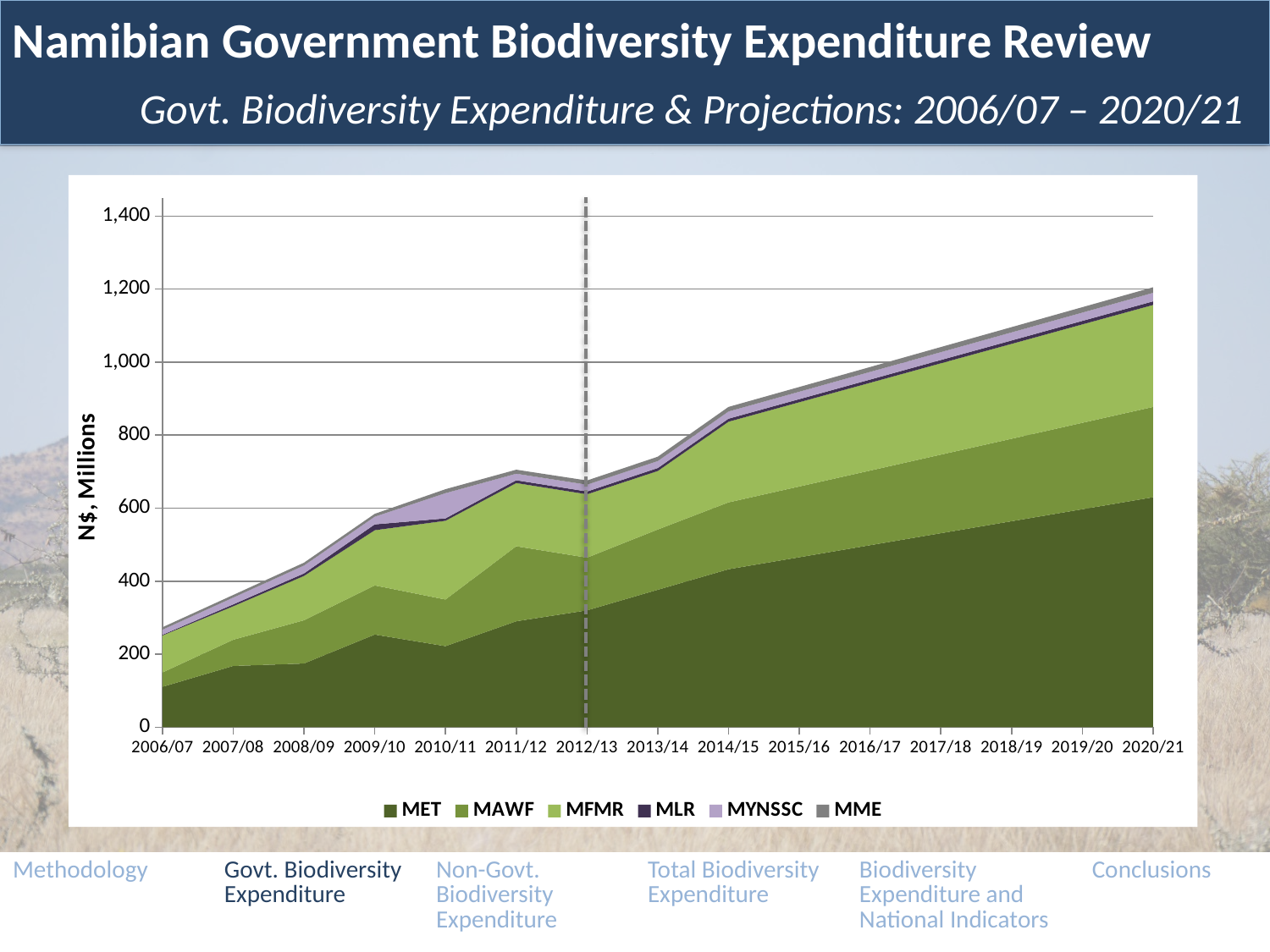
Is the total stacked expenditure for 2006/07 greater or less than 400? less Is the MET value for 2020/21 greater or less than 400? greater In which year is the total stacked expenditure lowest? 2006/07 Does total government biodiversity expenditure generally rise or fall from 2006/07 to 2020/21? Rise Is the total stacked expenditure for 2020/21 greater or less than 1,000? greater What kind of chart is shown on the slide? Stacked area chart In which year is the total stacked expenditure highest? 2020/21 Which year has the larger total stacked expenditure, 2011/12 or 2014/15? 2014/15 How many fiscal years are shown along the x axis of the chart? 15 What is the label on the chart's vertical axis? N$, Millions How many series does the chart's legend list? 6 Which series is listed first in the chart's legend? MET